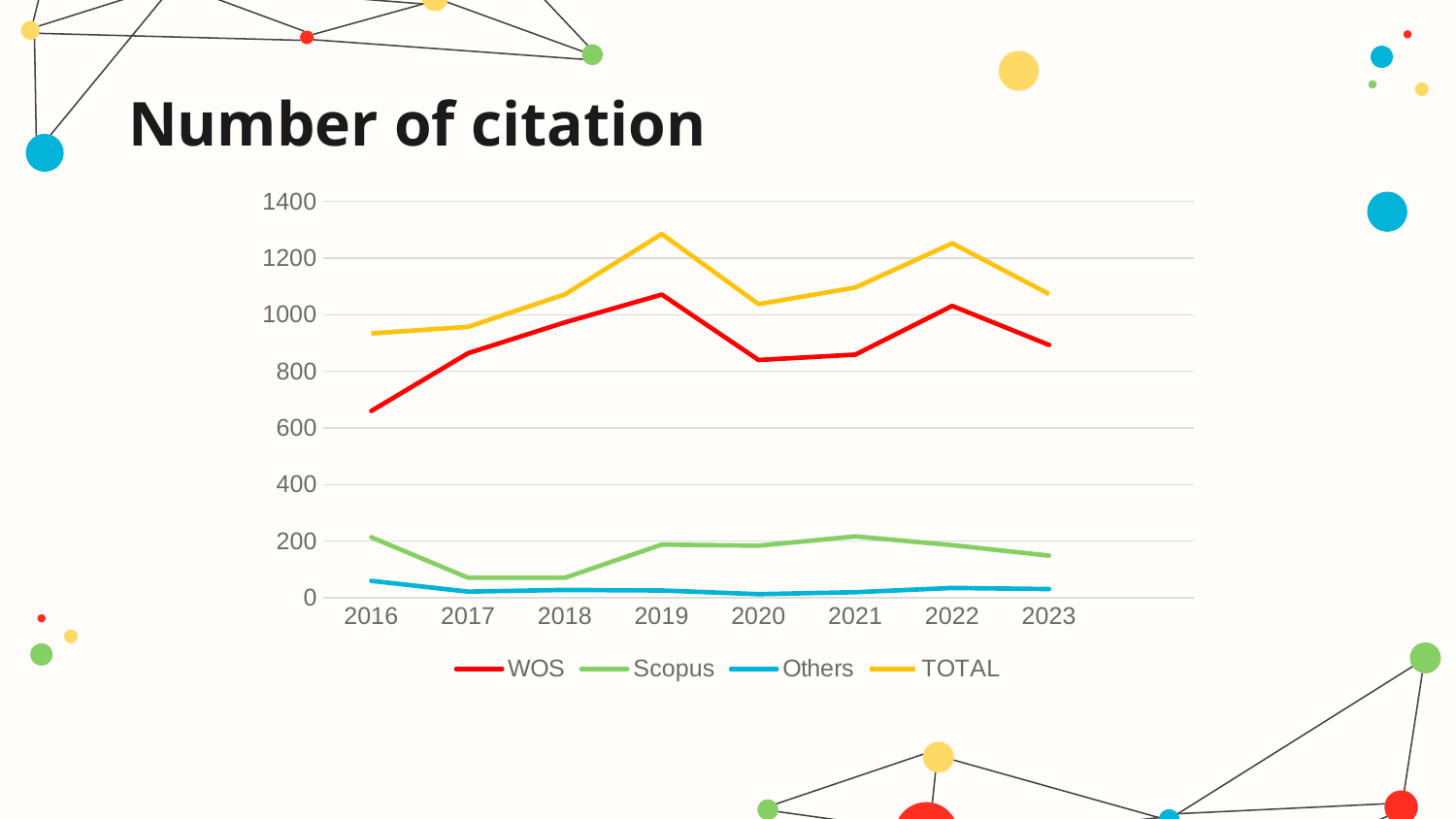
Is the value for TOTAL in 2019 greater or less than 1200? greater Is the value for WOS in 2020 greater or less than 1000? less Is the value for WOS in 2016 greater or less than 800? less Does the WOS series rise or fall from 2016 to 2019? rise In which year is the WOS series at its lowest? 2016 What kind of chart is shown on the slide? line chart What is the title of the chart? Number of citation Which series has the larger value in 2019, WOS or Scopus? WOS How many years are shown on the x axis? 8 Which colour is used for the TOTAL series? yellow How many series does the legend list? 4